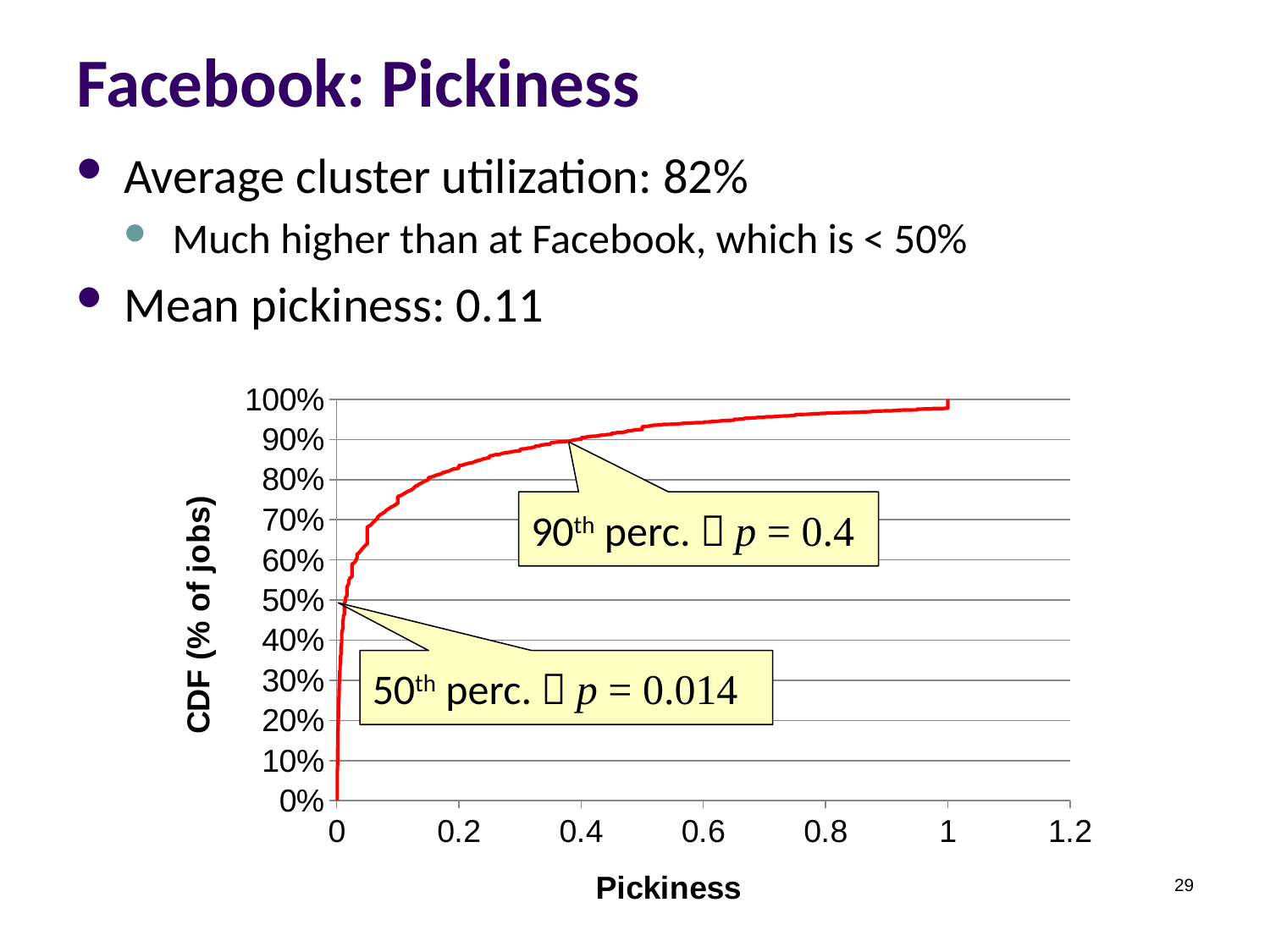
What is the label of the y axis of the chart? CDF (% of jobs) What kind of chart is shown on the slide? line chart According to the annotation, what pickiness value p corresponds to the 90th percentile? 0.4 What is the label of the x axis of the chart? Pickiness Is the CDF value at a pickiness of 0.8 greater or less than 100%? less According to the annotation, what pickiness value p corresponds to the 50th percentile? 0.014 Does the CDF curve rise or fall as pickiness increases along the x axis? rise Is the CDF value at a pickiness of 0.2 greater or less than 70%? greater Is the CDF value at a pickiness of 0.6 greater or less than 90%? greater What is the largest tick value shown on the x axis of the chart? 1.2 Which is larger: the pickiness at the 90th percentile or the pickiness at the 50th percentile? 90th percentile